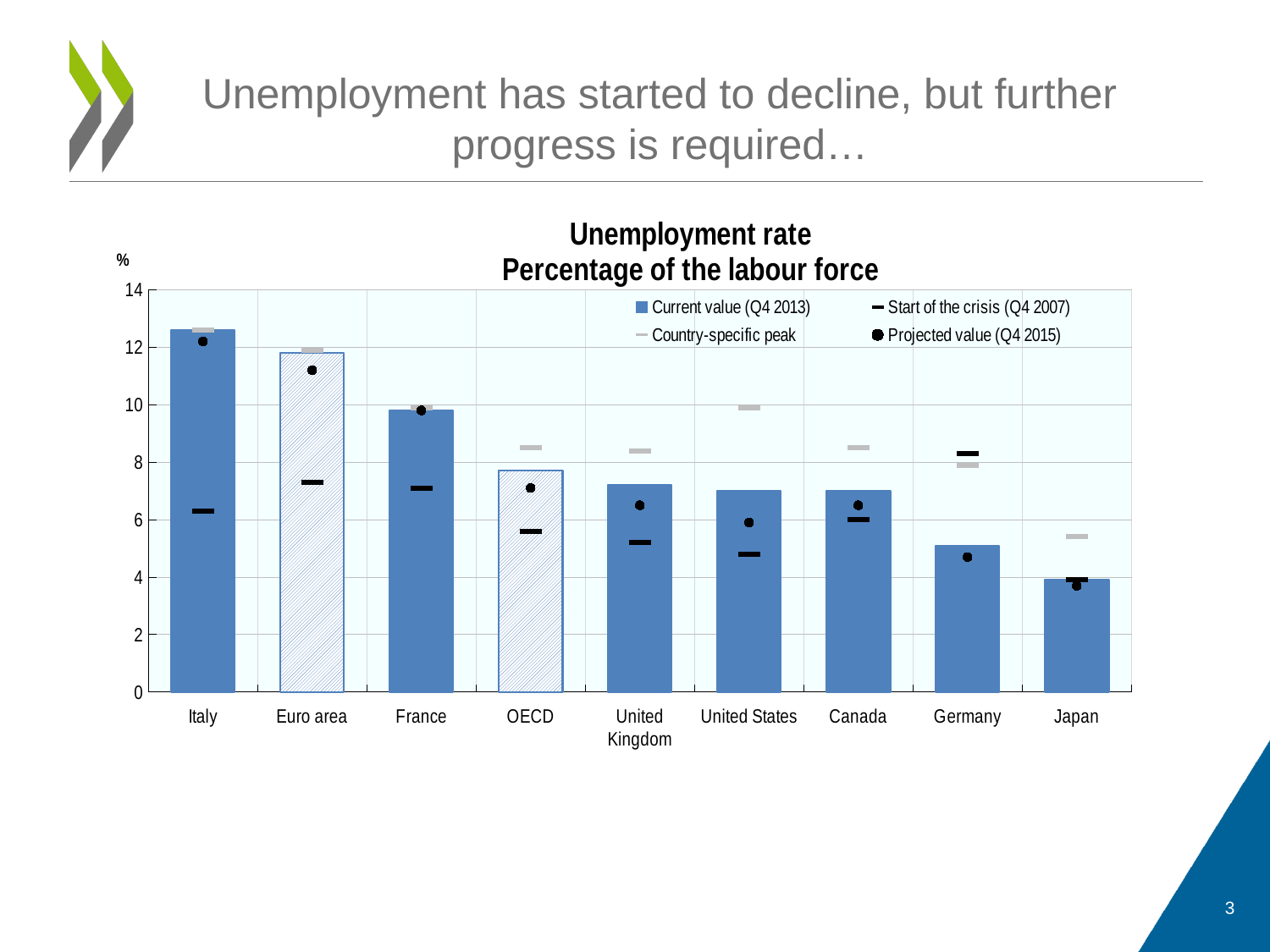
Is the current value (Q4 2013) for Germany greater or less than 6? less What is the title of the chart? Unemployment rate Percentage of the labour force What kind of chart is shown on the slide? bar chart Is the current value (Q4 2013) for Japan greater or less than 6? less Do the current value (Q4 2013) bars rise or fall from left to right along the x axis? fall Which has a higher current value (Q4 2013): France or Germany? France Is the current value (Q4 2013) for Italy greater or less than 12? greater Which category has the highest current value (Q4 2013) unemployment rate? Italy How many series does the legend list? 4 Which category has the lowest current value (Q4 2013) unemployment rate? Japan How many categories are shown on the x axis? 9